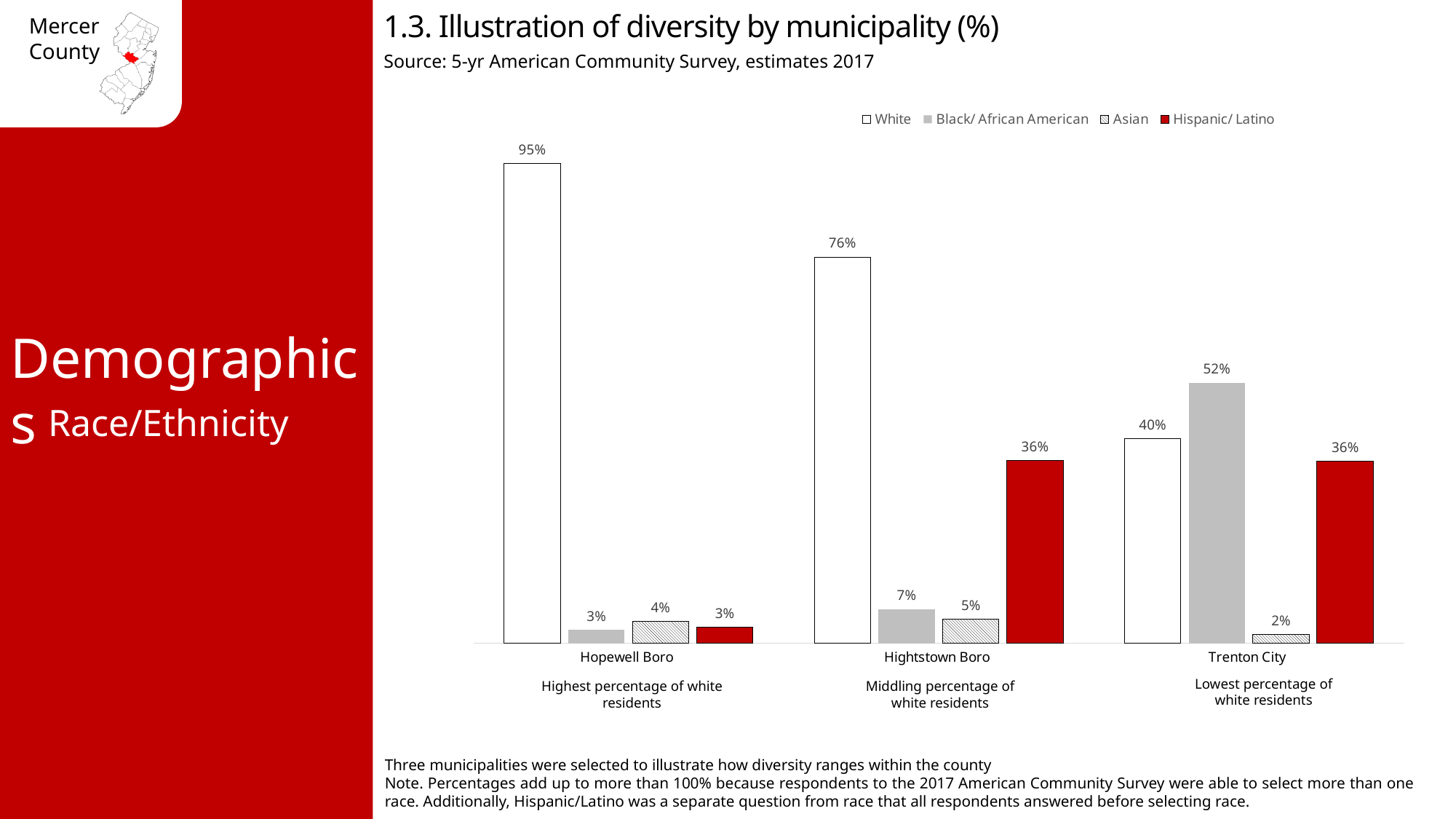
How many municipalities are shown on the chart? 3 What is the Asian percentage for Trenton City? 2% Which is larger for Trenton City, the White percentage or the Black/ African American percentage? Black/ African American What is the White percentage for Hopewell Boro? 95% What is the Hispanic/ Latino percentage for Hightstown Boro? 36% Which municipality has the highest White percentage? Hopewell Boro Which series is shown in red on the chart? Hispanic/ Latino What is the Black/ African American percentage for Trenton City? 52% What is the difference between the White percentages for Hopewell Boro and Trenton City? 55% Which municipality has the lowest Asian percentage? Trenton City How many series does the legend list? 4 What kind of chart is shown on the slide? Bar chart